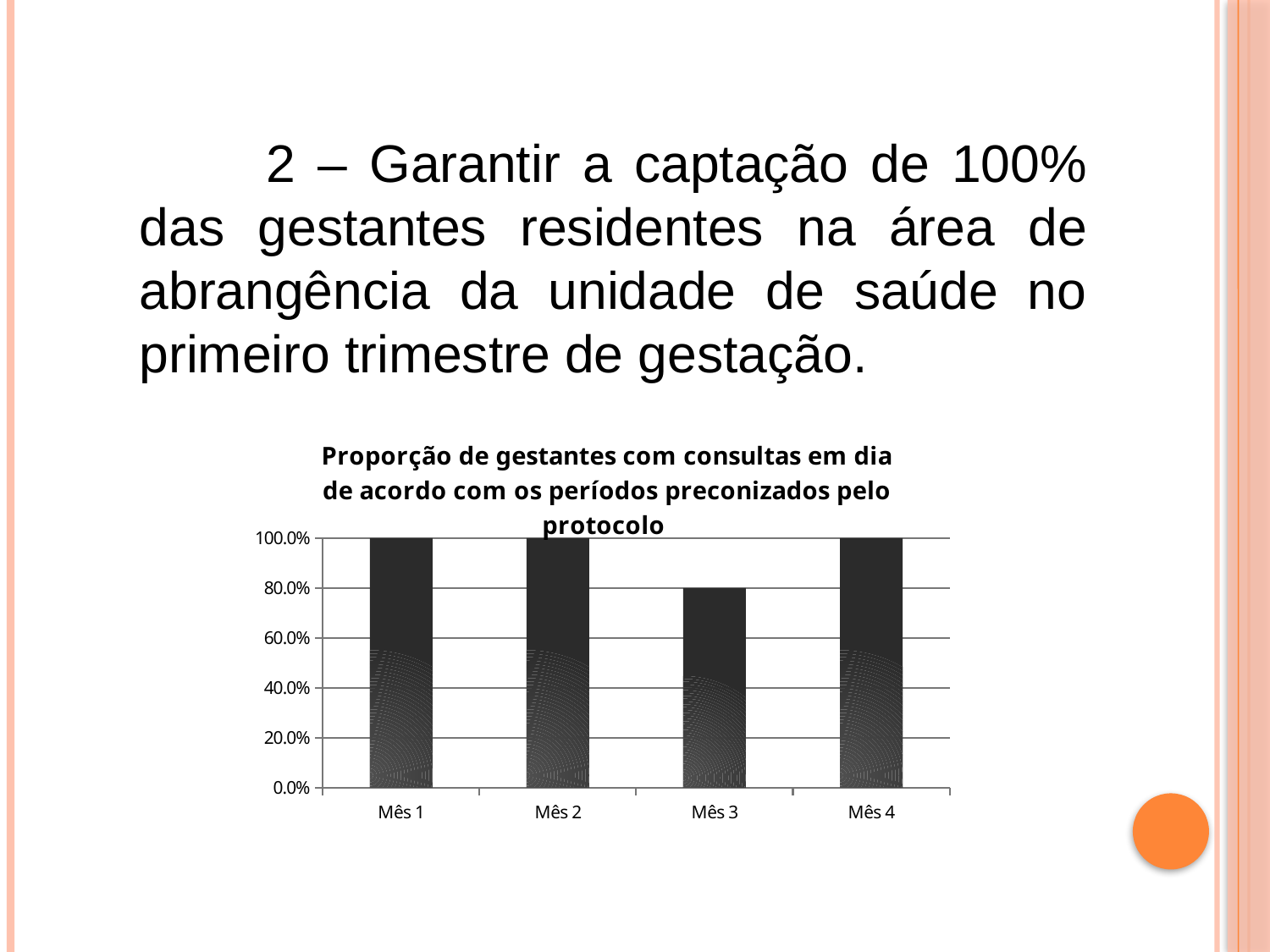
What is the value for Mês 3? 80.0% What kind of chart is shown on the slide? bar chart What is the value for Mês 4? 100.0% How many months reach 100.0%? 3 What is the difference between the values for Mês 2 and Mês 3? 20.0% How many months are shown on the x axis? 4 What is the value for Mês 1? 100.0% Is the value for Mês 3 greater or less than 60.0%? greater Which is larger, the value for Mês 2 or the value for Mês 3? Mês 2 What is the title of the chart? Proporção de gestantes com consultas em dia de acordo com os períodos preconizados pelo protocolo Does the value rise or fall from Mês 2 to Mês 3? fall Which month has the lowest value? Mês 3